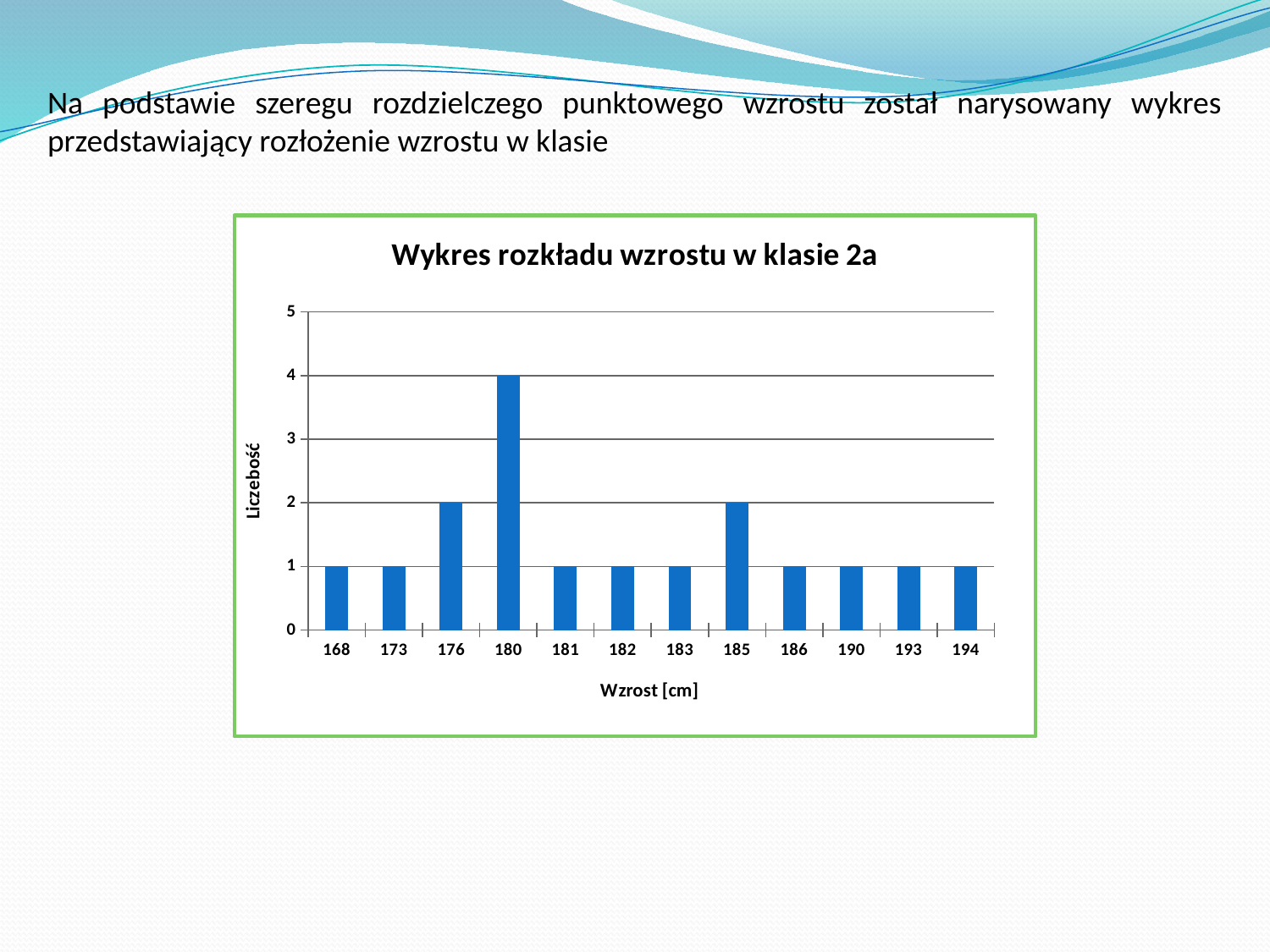
How many height categories are shown on the x axis? 12 Is the value for 180 cm greater or less than 3? greater What is the value for height 180 cm? 4 What is the difference between the values for 180 cm and 176 cm? 2 What kind of chart is shown on the slide? bar chart Which height has the highest count? 180 Which is larger, the value for 176 cm or the value for 181 cm? 176 What is the value for height 176 cm? 2 What is the title of the chart? Wykres rozkładu wzrostu w klasie 2a What is the value for height 185 cm? 2 What is the label of the x axis? Wzrost [cm] What is the value for height 168 cm? 1